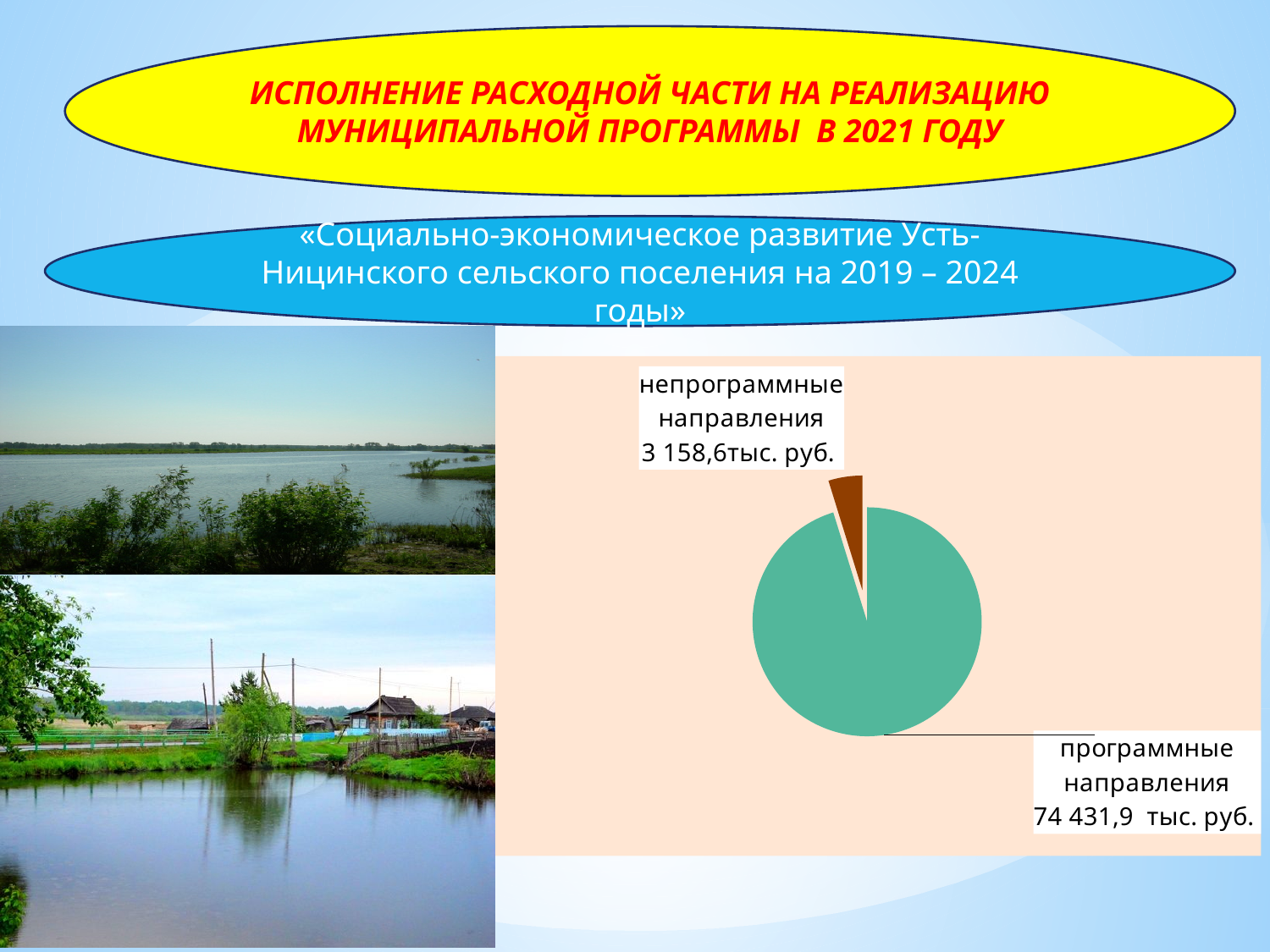
What is the value shown for «непрограммные направления» in the pie chart? 3 158,6 тыс. руб. Which slice of the pie chart is the smallest? непрограммные направления What share of the pie, to one decimal place, does «непрограммные направления» represent? 4.1% What is the total of the two slices in the pie chart in тыс. руб.? 77 590,5 тыс. руб. What is the difference between «программные направления» and «непрограммные направления» in тыс. руб.? 71 273,3 тыс. руб. How many slices does the pie chart have? 2 What kind of chart is shown on the slide? pie chart Which is larger: «программные направления» or «непрограммные направления»? программные направления What is the value shown for «программные направления» in the pie chart? 74 431,9 тыс. руб. What colour is the slice for «программные направления»? green What colour is the slice for «непрограммные направления»? brown Which slice of the pie chart is the largest? программные направления